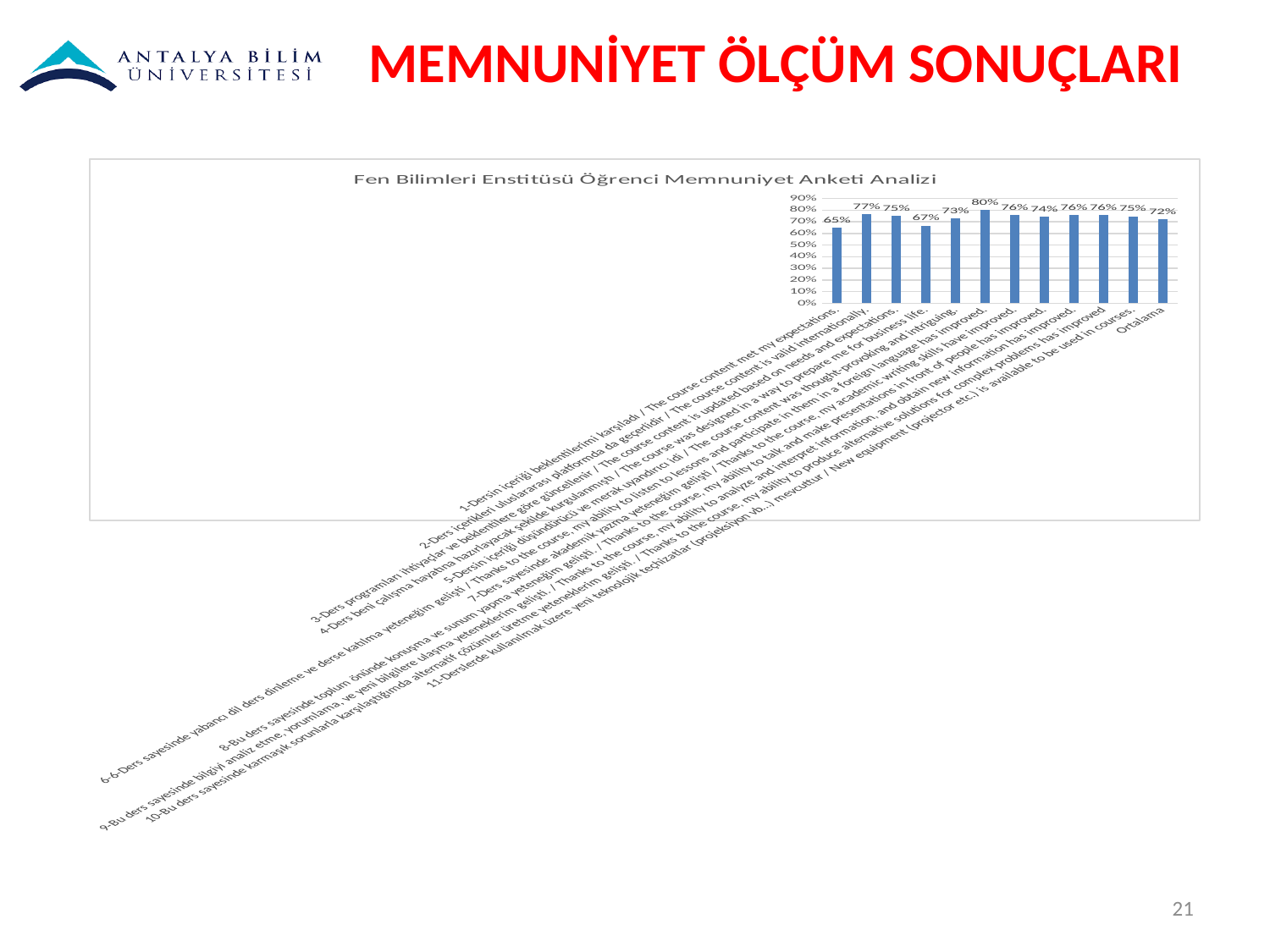
Which is larger: the value for the category starting with '2-Ders içerikleri' or the value for 'Ortalama'? 2-Ders içerikleri What is the value for the 'Ortalama' category? 72% What is the value for the first category (1-Dersin içeriği beklentilerimi karşıladı)? 65% What kind of chart is shown on the slide? bar chart What is the value for the category starting with '4-Ders beni çalışma hayatına'? 67% Which category has the highest value? 6-Ders sayesinde yabancı dil ders dinleme ve derse katılma yeteneğim gelişti What is the title of the chart? Fen Bilimleri Enstitüsü Öğrenci Memnuniyet Anketi Analizi Which category has the lowest value? 1-Dersin içeriği beklentilerimi karşıladı Is the value for the category starting with '5-Dersin içeriği düşündürücü' greater or less than 60%? greater What is the value for the category starting with '6-Ders sayesinde yabancı dil'? 80% What is the difference between the highest value (80%) and the lowest value (65%)? 15% How many bars are plotted in the chart? 12